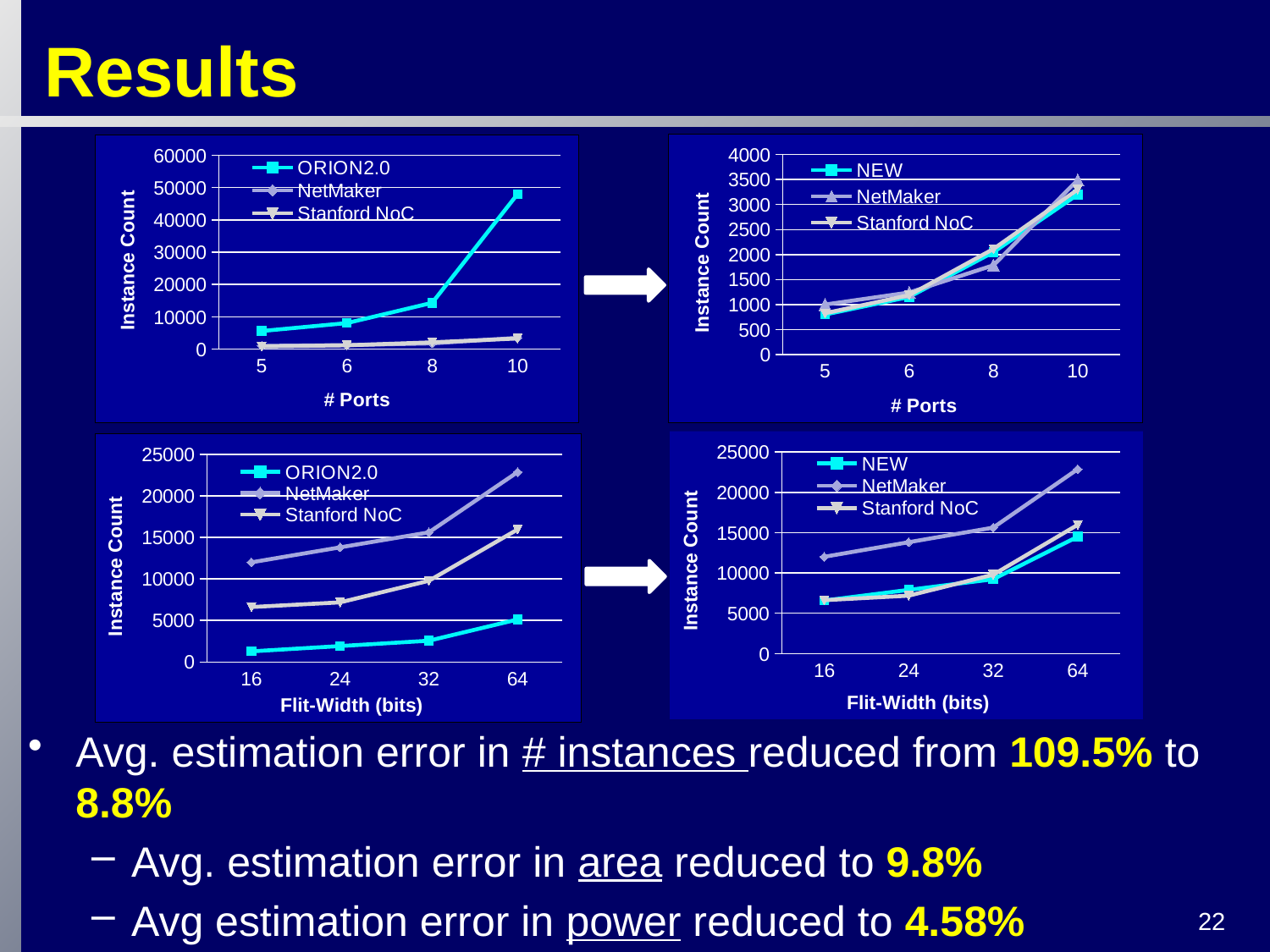
How many # Ports values are plotted along the x axis of the top-left chart? 4 In the top-left chart, which series has the highest instance count at 10 ports? ORION2.0 In the bottom-left chart, is the NetMaker value at 64 bits greater or less than 20000? greater What are the legend entries of the top-right chart? NEW, NetMaker, Stanford NoC In the bottom-left chart, which series has the lowest instance count at 64 bits? ORION2.0 How many series does the legend of the top-left chart list? 3 What is the x-axis title of the bottom-right chart? Flit-Width (bits) In the top-left chart, is the ORION2.0 value at 10 ports greater or less than 40000? greater In the top-left chart, does the ORION2.0 line rise or fall as # Ports increases? rise In the bottom-left chart, which series has the highest instance count at 16 bits? NetMaker In the bottom-right chart, which is larger at 16 bits: NetMaker or NEW? NetMaker What kind of chart is the top-left chart (Instance Count vs # Ports with ORION2.0)? line chart